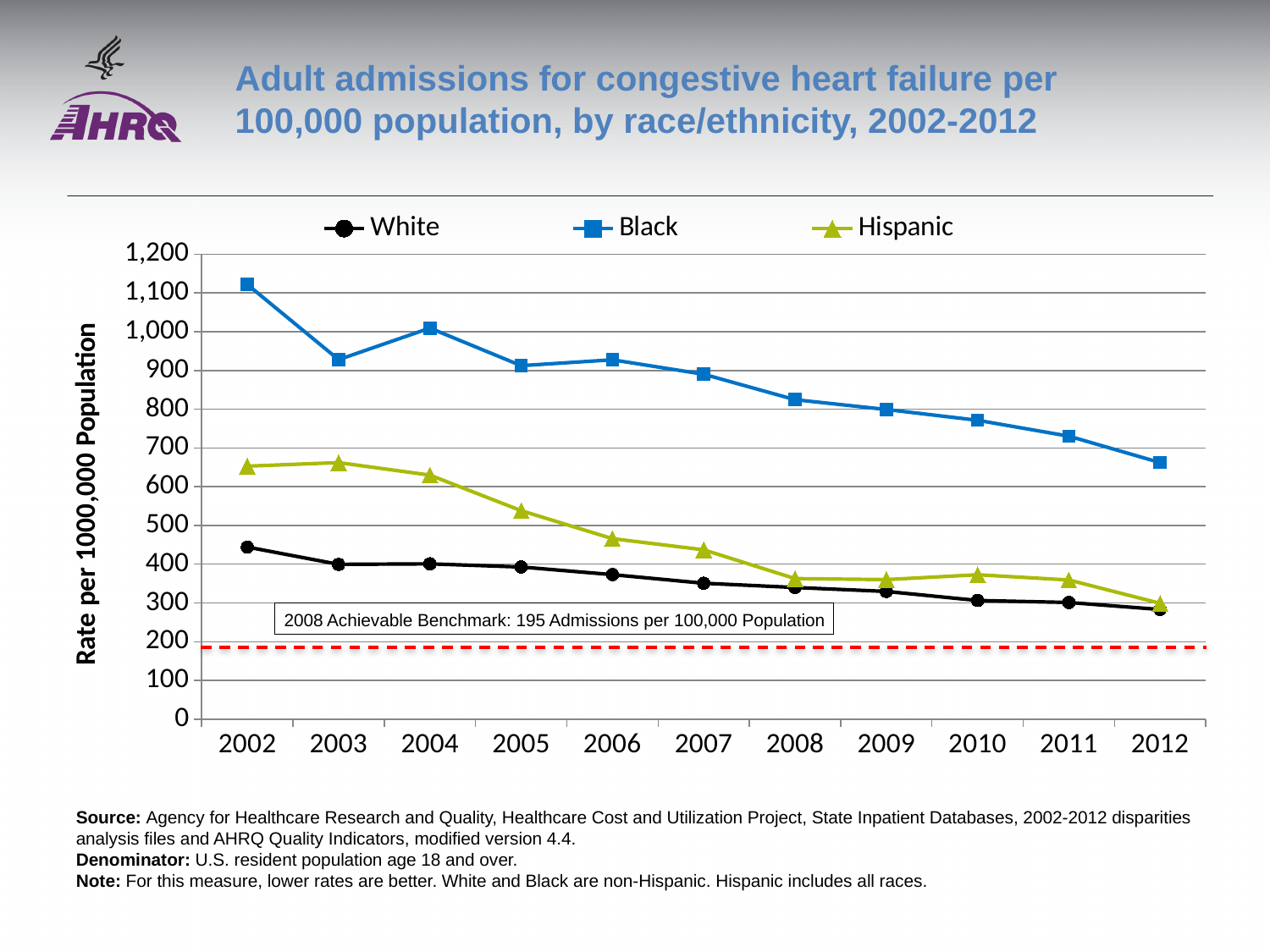
What is the 2008 achievable benchmark shown on the chart, in admissions per 100,000 population? 195 What kind of chart is shown on the slide? line chart Which race/ethnicity group has the highest admission rate in 2002? Black Is the value for White in 2002 greater or less than 400? greater How many series does the legend list? 3 In 2006, which is larger, the value for Hispanic or the value for White? Hispanic Is the value for Black in 2012 greater or less than 600? greater Which race/ethnicity group has the lowest admission rate in 2002? White Does the admission rate for Black adults rise or fall from 2002 to 2012? fall Is the value for Hispanic in 2005 greater or less than 500? greater How many years are plotted along the x axis? 11